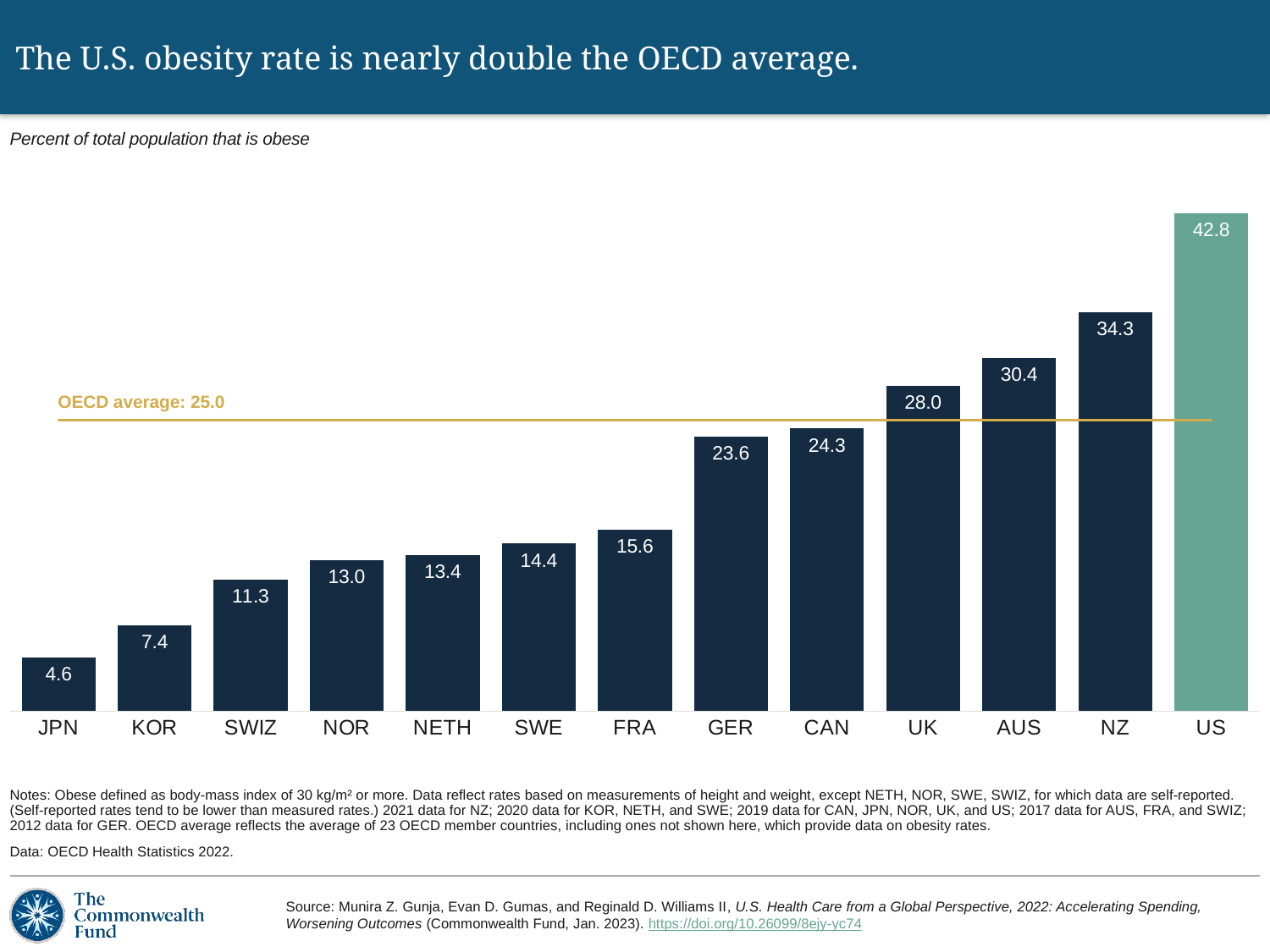
What is the difference between the obesity rates of KOR and JPN? 2.8 Do the obesity rates rise or fall from left to right across the chart? Rise Which has a higher obesity rate, CAN or UK? UK What is the obesity rate shown for the US? 42.8 What is the obesity rate shown for JPN? 4.6 Which country has the lowest obesity rate on the chart? JPN How many countries are shown on the chart? 13 What is the obesity rate shown for GER? 23.6 What is the difference between the obesity rates of the US and NZ? 8.5 Which country has the highest obesity rate on the chart? US What OECD average value is marked by the horizontal line on the chart? 25.0 What kind of chart is shown on the slide? Bar chart